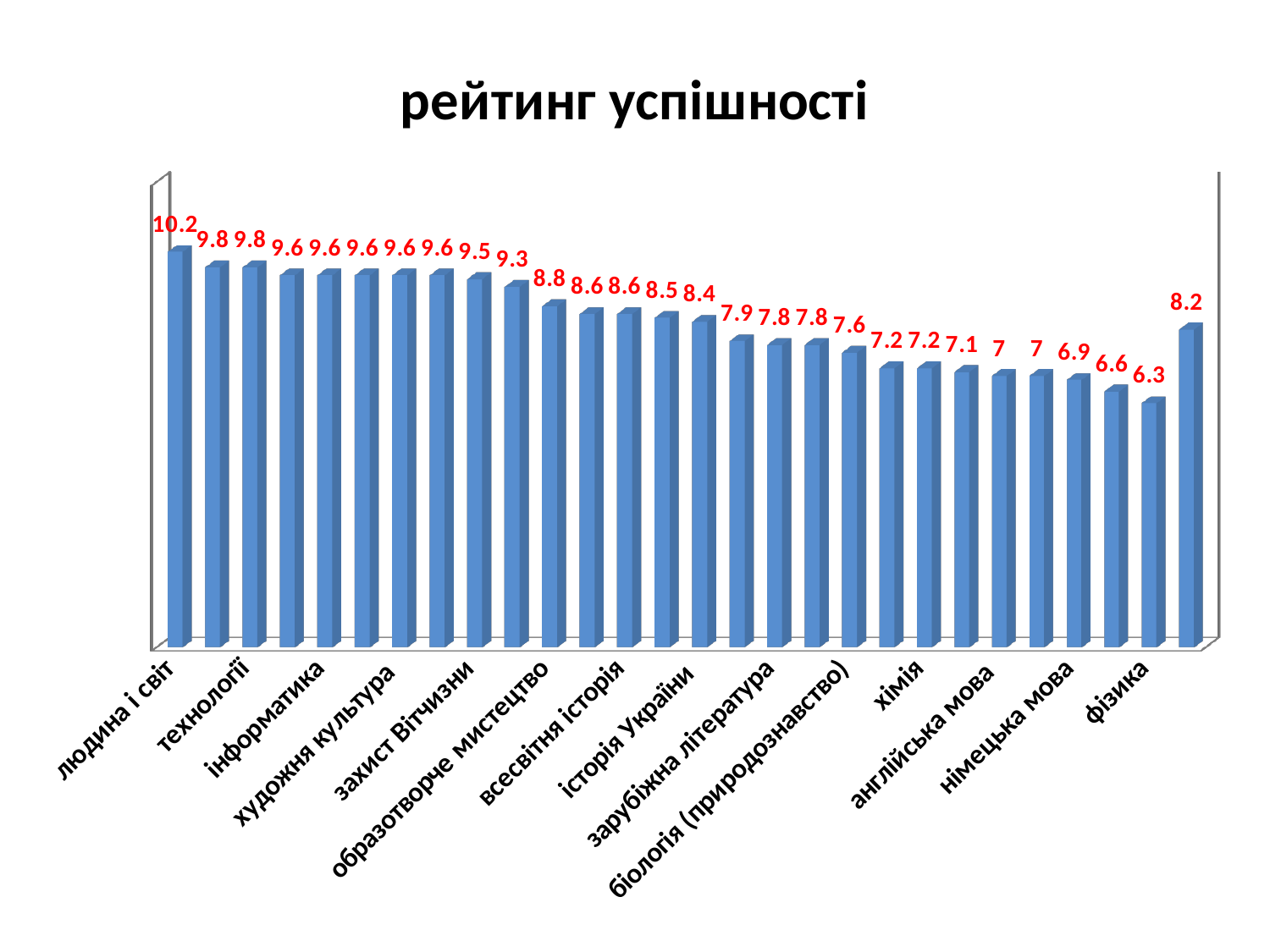
What is the value for людина і світ? 10.2 Do the values generally rise or fall from left to right across the chart (excluding the last bar)? fall What is the highest value shown on the chart? 10.2 What is the lowest value shown on the chart? 6.3 What is the difference between the highest value (10.2) and the lowest value (6.3)? 3.9 What is the value of the last (rightmost) bar? 8.2 How many bars are plotted on the chart? 28 What kind of chart is shown on the slide? bar chart Which category has the highest value? людина і світ How many bars have the value 9.6? 5 Which is larger, the value of the first bar (людина і світ) or the value of the last bar? the first bar (людина і світ) What is the title of the chart? рейтинг успішності